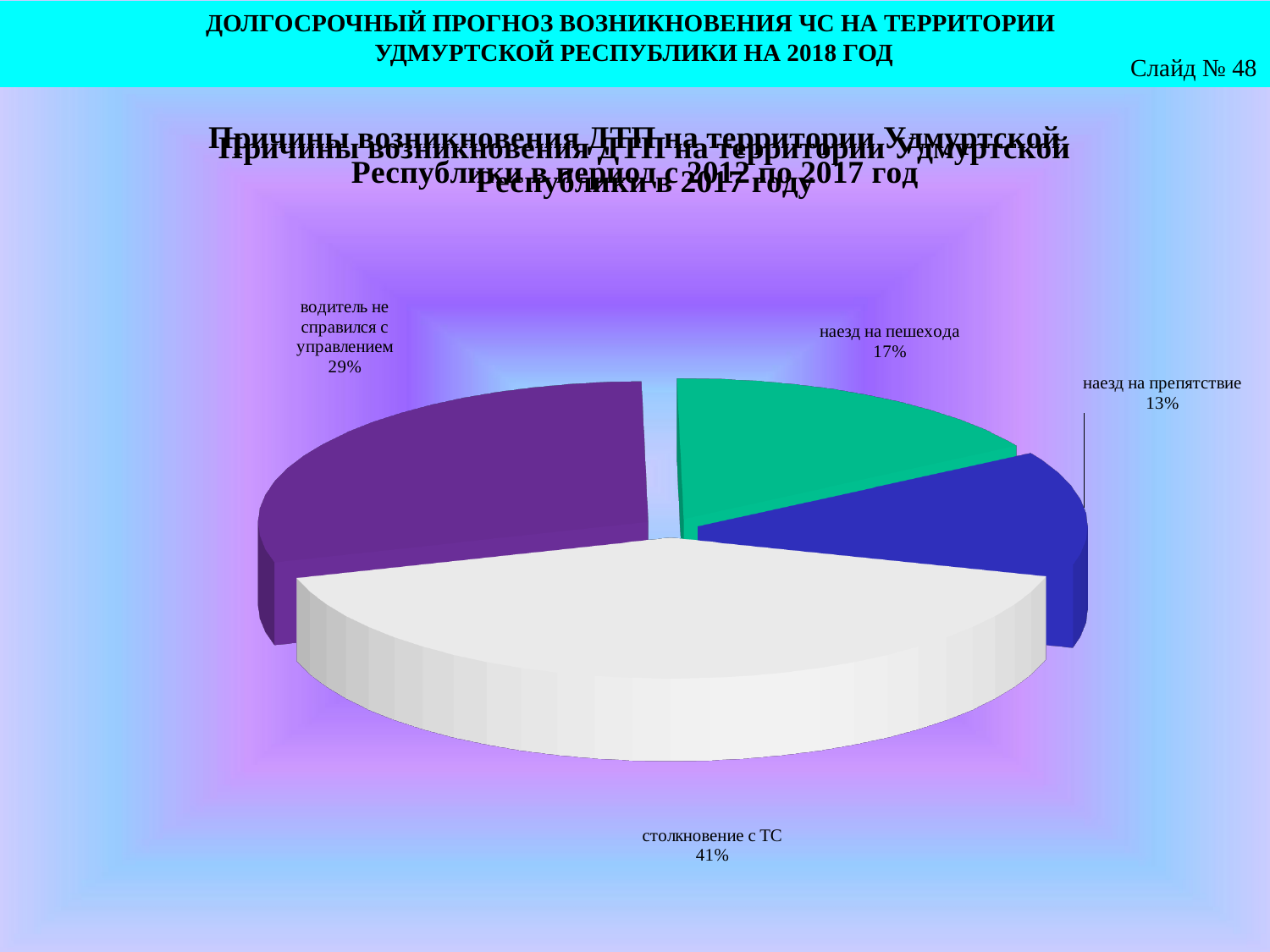
How many slices does the pie chart have? 4 What colour is the slice for "водитель не справился с управлением"? purple Which is larger: the share for "наезд на пешехода" or the share for "наезд на препятствие"? наезд на пешехода What type of chart is shown on the slide? pie chart What is the combined share of "наезд на пешехода" and "наезд на препятствие"? 30% What share of the pie is labelled "наезд на пешехода"? 17% What share of the pie is labelled "водитель не справился с управлением"? 29% Which category has the smallest share of the pie? наезд на препятствие What is the difference in percentage points between "столкновение с ТС" and "водитель не справился с управлением"? 12 What share of the pie is labelled "столкновение с ТС"? 41% What share of the pie is labelled "наезд на препятствие"? 13% Which category has the largest share of the pie? столкновение с ТС